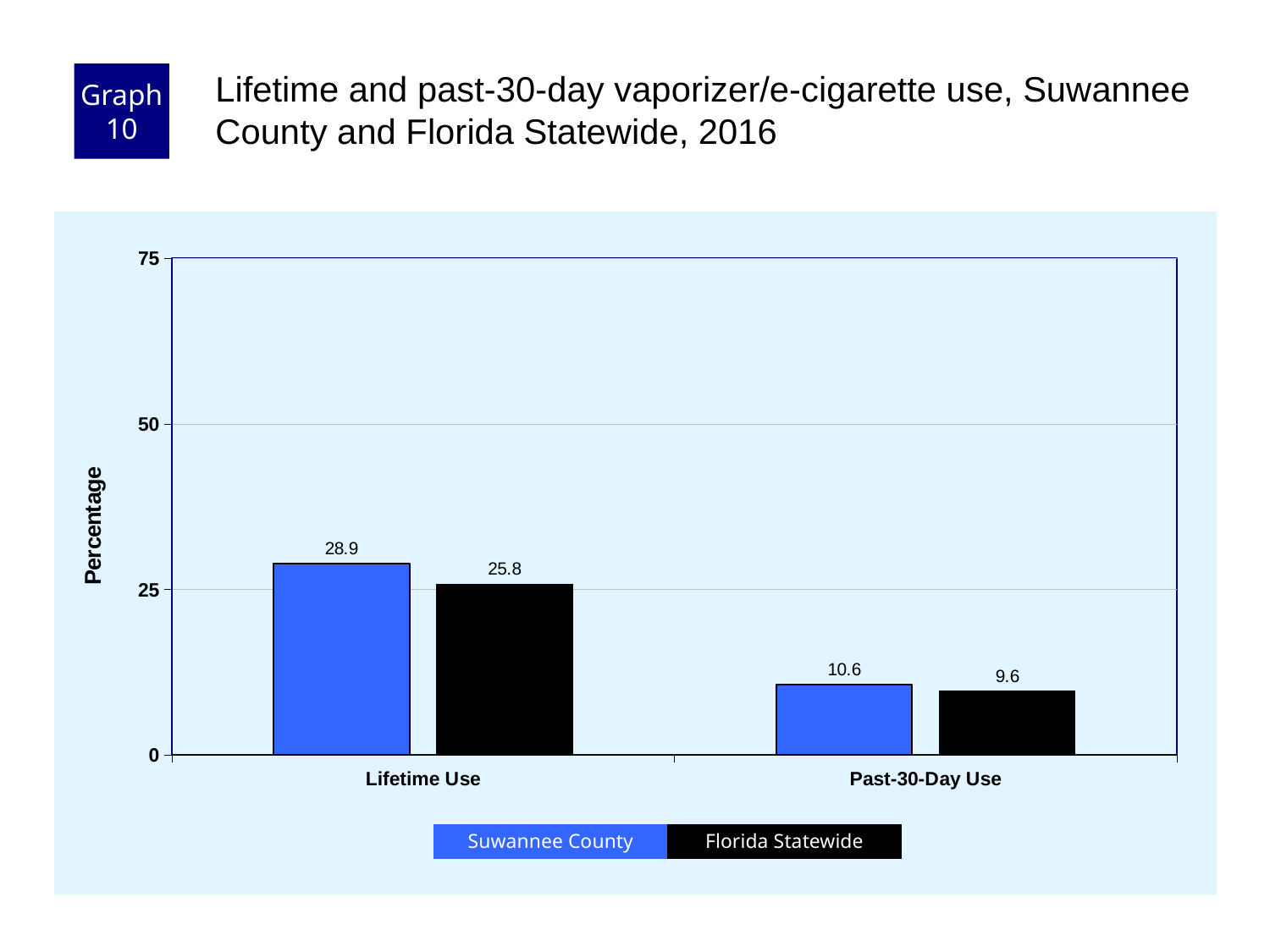
What is the Suwannee County value for Lifetime Use? 28.9 How many series does the legend list? 2 What is the difference between the Suwannee County and Florida Statewide values for Past-30-Day Use? 1.0 Which bar has the lowest value on the chart? Florida Statewide, Past-30-Day Use For Past-30-Day Use, which is larger: Suwannee County or Florida Statewide? Suwannee County Which bar has the highest value on the chart? Suwannee County, Lifetime Use What kind of chart is shown on the slide? Bar chart What is the difference between the Suwannee County and Florida Statewide values for Lifetime Use? 3.1 What is the Florida Statewide value for Past-30-Day Use? 9.6 What is the Suwannee County value for Past-30-Day Use? 10.6 How many categories are shown on the x axis? 2 What is the Florida Statewide value for Lifetime Use? 25.8